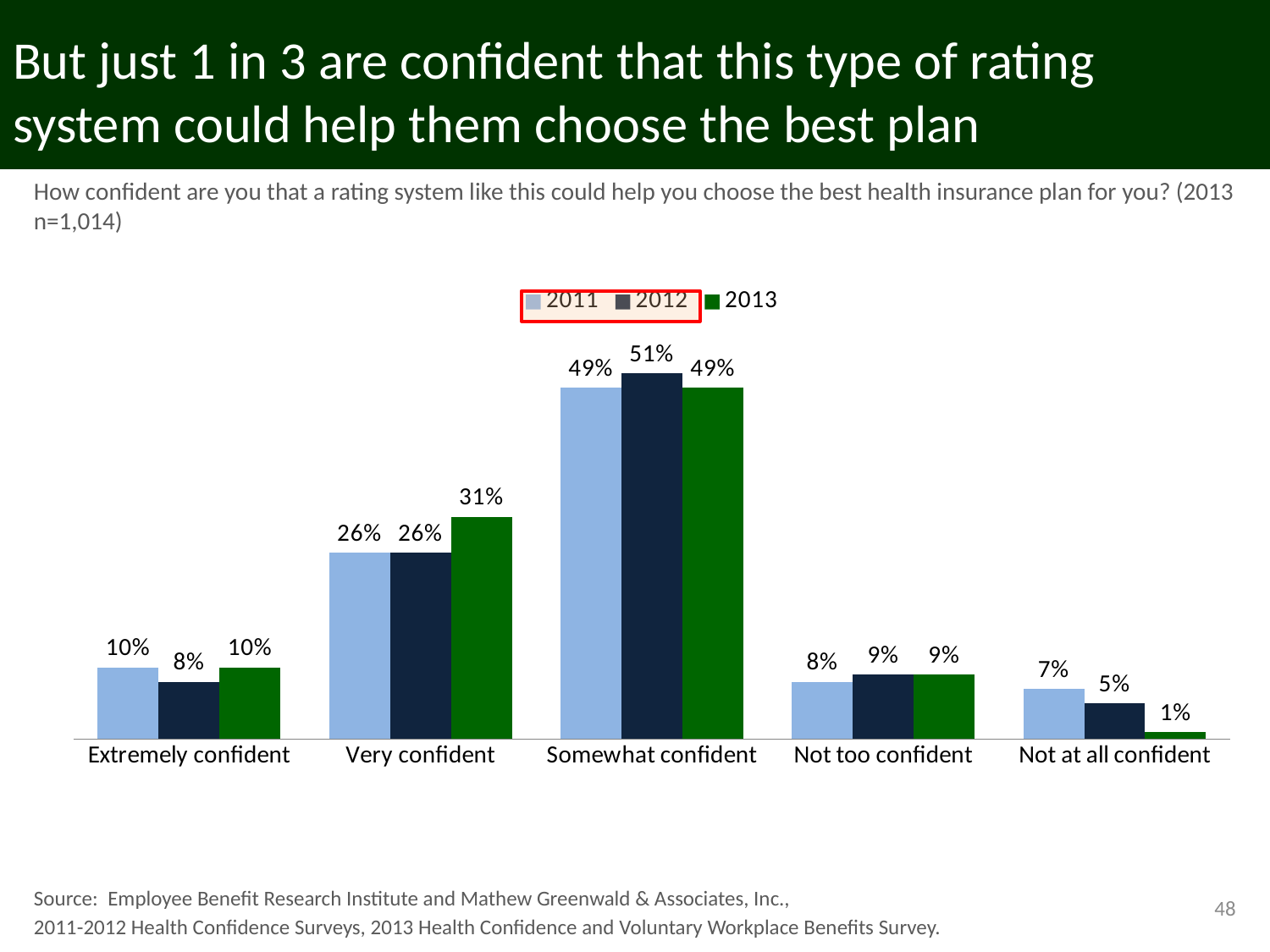
How many series does the legend list? 3 What kind of chart is shown on the slide? Bar chart Which category has the lowest 2012 value? Not at all confident What is the 2013 value for Very confident? 31% Which is larger for Extremely confident: the 2011 value or the 2012 value? 2011 What is the 2011 value for Not at all confident? 7% How many categories are shown on the x axis? 5 What is the 2013 value for Not at all confident? 1% What is the difference between the 2013 and 2011 values for Very confident? 5% Which series is shown in green in the legend? 2013 Which category has the highest 2013 value? Somewhat confident What is the 2012 value for Somewhat confident? 51%